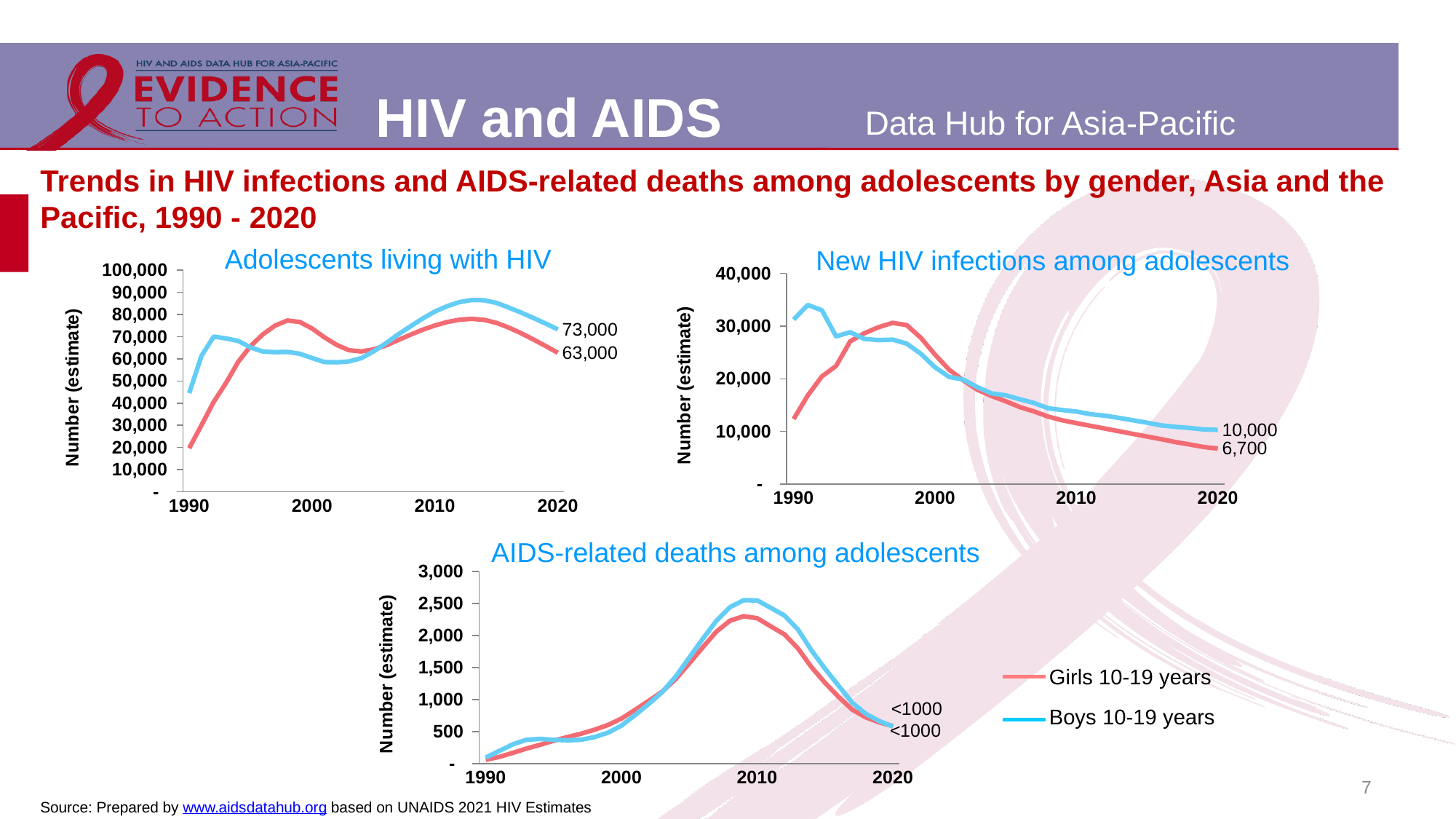
In the 'New HIV infections among adolescents' chart, do the values for Boys 10-19 years rise or fall between 2000 and 2020? fall In the 'New HIV infections among adolescents' chart, what is the 2020 value for Girls 10-19 years? 6,700 How many series does the legend list? 2 In the 'Adolescents living with HIV' chart, what is the difference between the 2020 values for boys and girls? 10,000 In the 'New HIV infections among adolescents' chart, what is the 2020 value for Boys 10-19 years? 10,000 In the 'New HIV infections among adolescents' chart, is the value for Girls 10-19 years in 1990 greater or less than 20,000? less In the 'Adolescents living with HIV' chart, what is the 2020 value for Girls 10-19 years? 63,000 In the 'Adolescents living with HIV' chart, which series has the higher value in 2020, Girls 10-19 years or Boys 10-19 years? Boys 10-19 years What kind of chart is the 'AIDS-related deaths among adolescents' chart? line chart In the 'Adolescents living with HIV' chart, what is the 2020 value for Boys 10-19 years? 73,000 In the 'New HIV infections among adolescents' chart, what is the difference between the 2020 values for boys and girls? 3,300